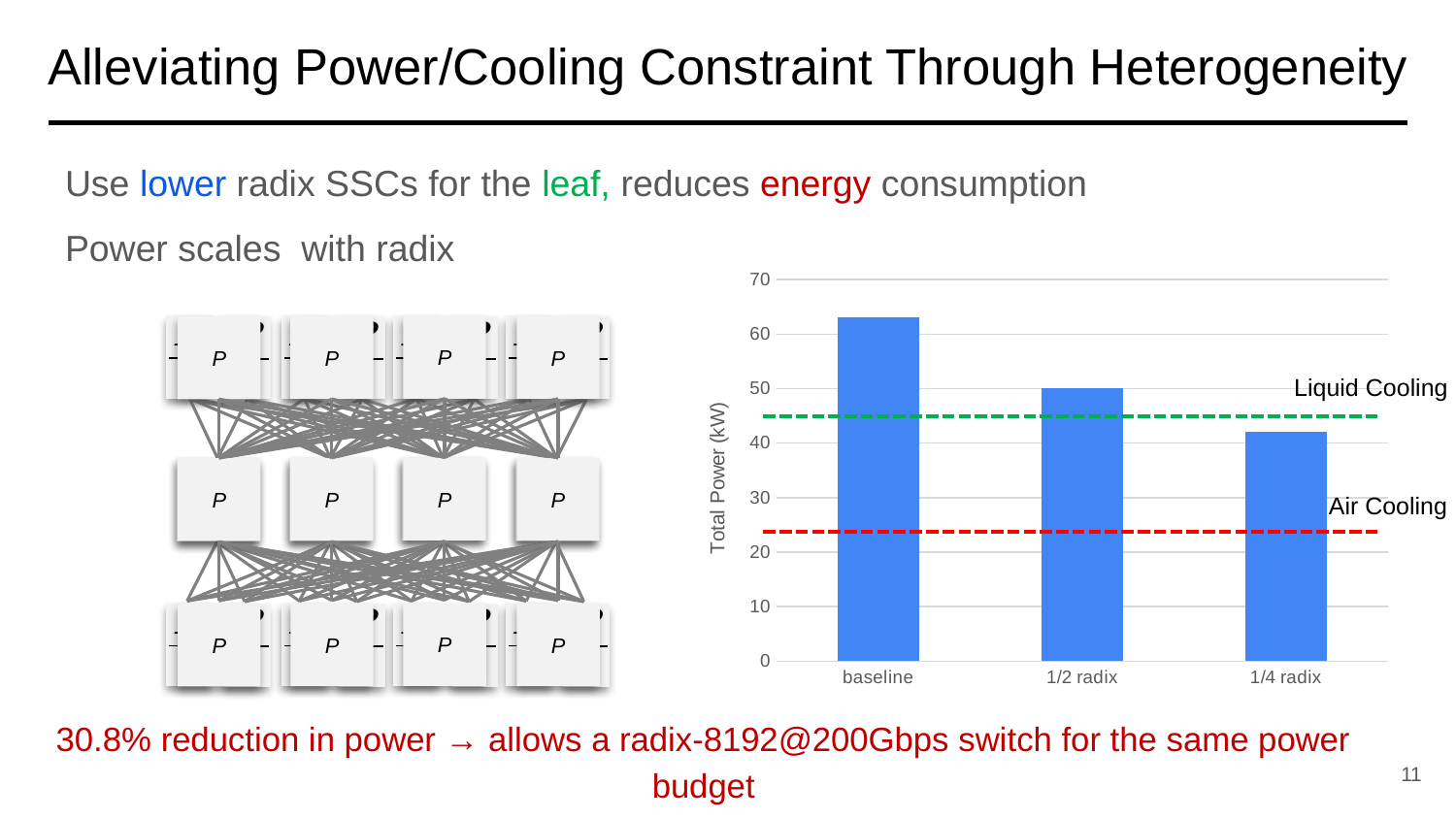
How many categories are plotted on the x axis of the chart? 3 Is the value for 1/4 radix greater or less than 50? less What is the label of the y axis of the chart? Total Power (kW) Which has a larger total power, 1/2 radix or 1/4 radix? 1/2 radix What does the green dashed horizontal line in the chart represent? Liquid Cooling Which category has the lowest total power in the chart? 1/4 radix Is the value for baseline greater or less than 60? greater Is the value for 1/2 radix greater or less than 40? greater What kind of chart is shown on the slide? bar chart Which category has the highest total power in the chart? baseline Which has a larger total power, baseline or 1/4 radix? baseline Do the bar values rise or fall from baseline to 1/4 radix along the x axis? fall